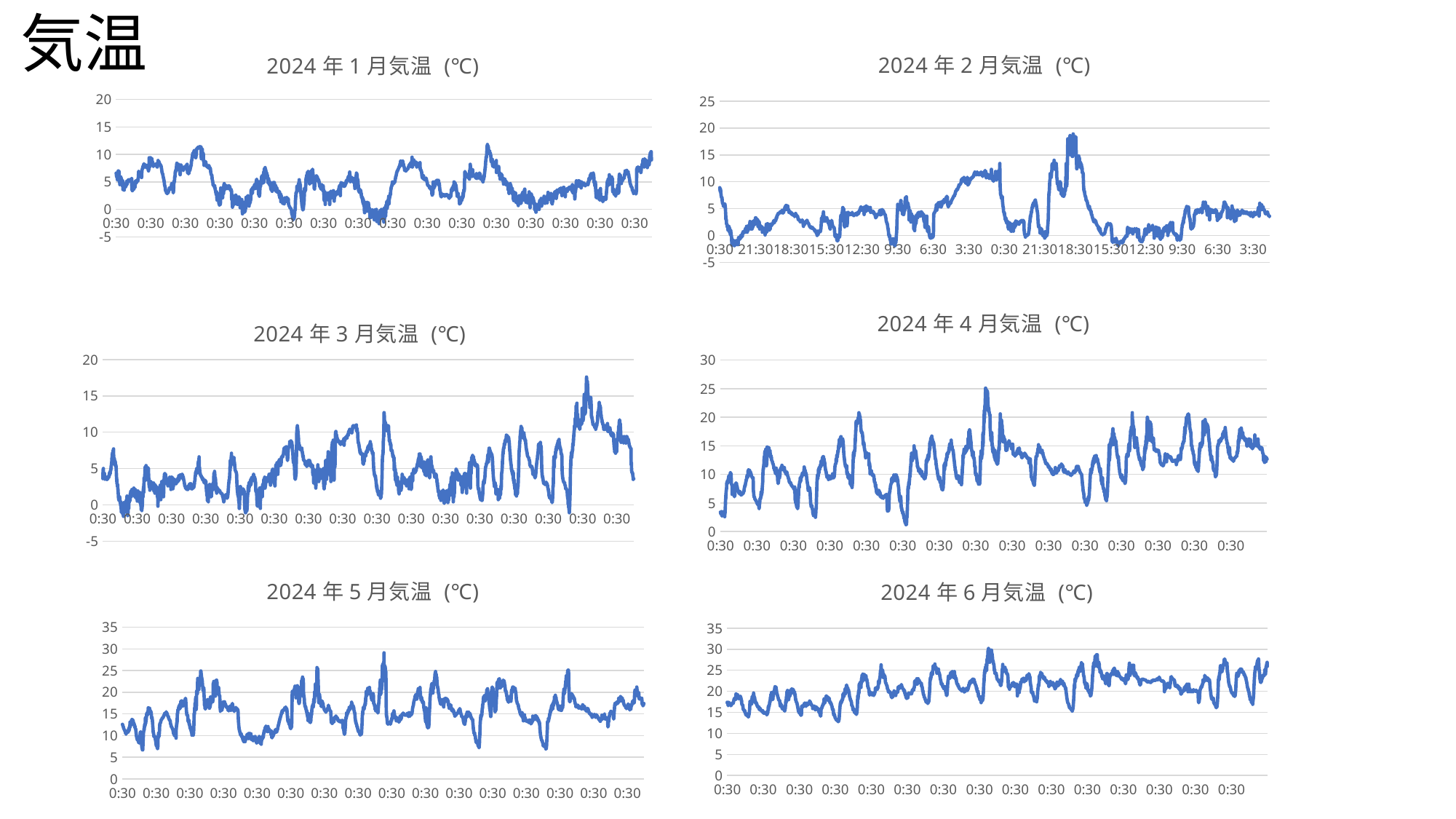
In the 2024年4月気温（℃） chart, is the lowest value greater or less than 5? less Which chart reaches a higher peak value, 2024年1月気温（℃） or 2024年6月気温（℃）? 2024年6月気温（℃） In the 2024年4月気温（℃） chart, is the highest value greater or less than 20? greater What is the top value shown on the vertical axis of the 2024年6月気温（℃） chart? 35 In the 2024年6月気温（℃） chart, is the highest value greater or less than 25? greater What kind of chart is the 2024年1月気温（℃） chart? line chart How many charts are shown on the slide? 6 In the 2024年6月気温（℃） chart, do the values generally rise or fall from left to right? rise